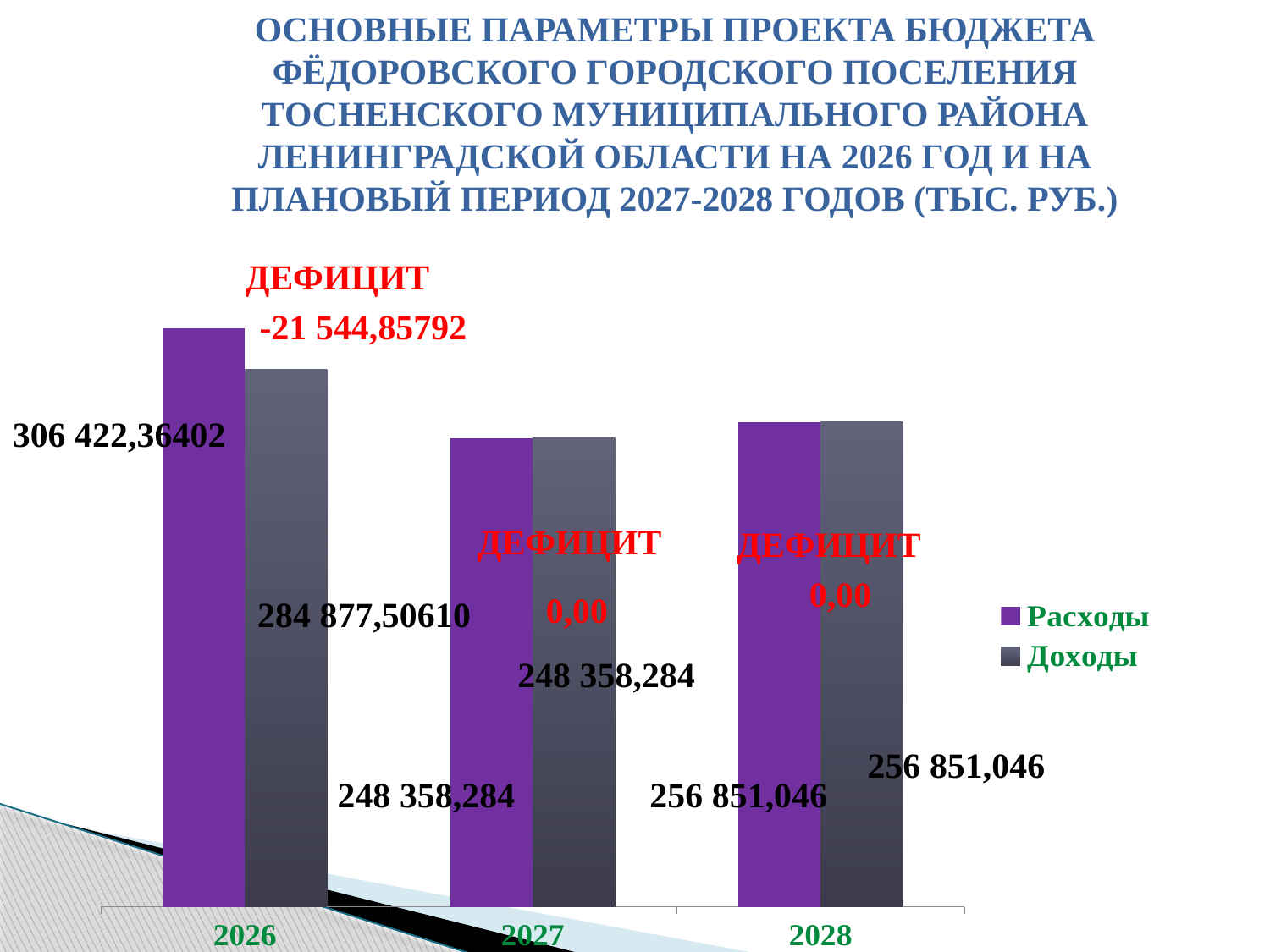
What is the value of Расходы for 2026? 306 422,36402 What is the value of Доходы for 2026? 284 877,50610 What is the value of Расходы for 2027? 248 358,284 What is the value of Доходы for 2028? 256 851,046 How many years (categories) are shown on the x axis? 3 Which series is shown in purple according to the legend? Расходы What type of chart is shown on the slide? bar chart Which year has the highest value for Расходы? 2026 Which year has the lowest value for Доходы? 2027 What deficit (ДЕФИЦИТ) is shown for 2026? -21 544,85792 How many series does the legend list? 2 Which is larger in 2026, Расходы or Доходы? Расходы